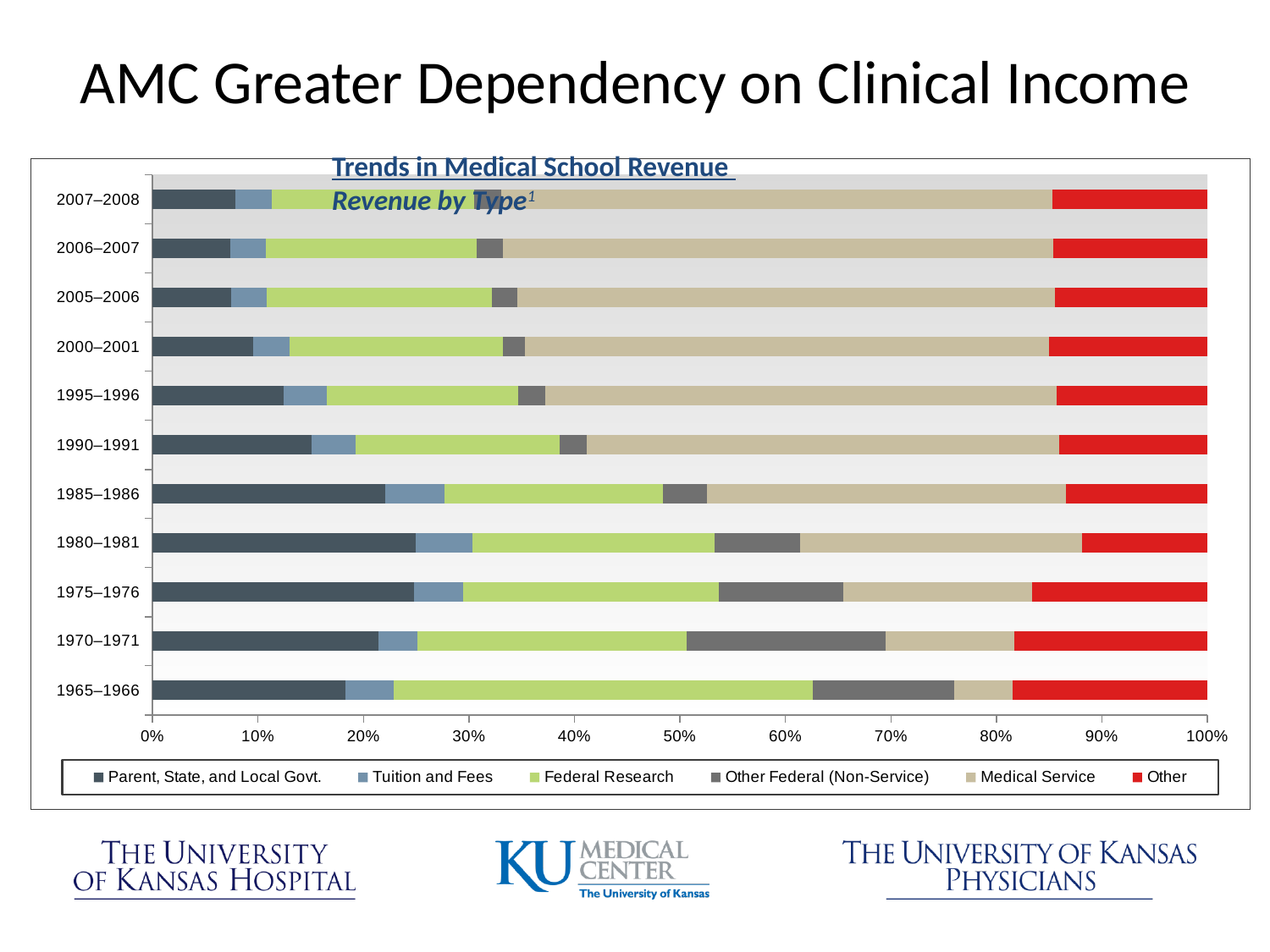
What is the title of the chart? Trends in Medical School Revenue How many series does the chart legend list? 6 Which year has the largest Federal Research share of revenue? 1965–1966 Does the Medical Service share of revenue rise or fall from 1965–1966 to 2007–2008? Rise How many academic-year categories are plotted on the chart? 11 Is the Parent, State, and Local Govt. share for 2007–2008 greater or less than 10%? less Is the Parent, State, and Local Govt. share for 1980–1981 greater or less than 20%? greater What kind of chart is shown on the slide? Stacked bar chart Does the Federal Research share of revenue rise or fall from 1965–1966 to 2007–2008? Fall Which is larger, the Medical Service share in 2007–2008 or in 1965–1966? 2007–2008 Which year has the smallest Medical Service share of revenue? 1965–1966 Which series is shown in red in the legend? Other